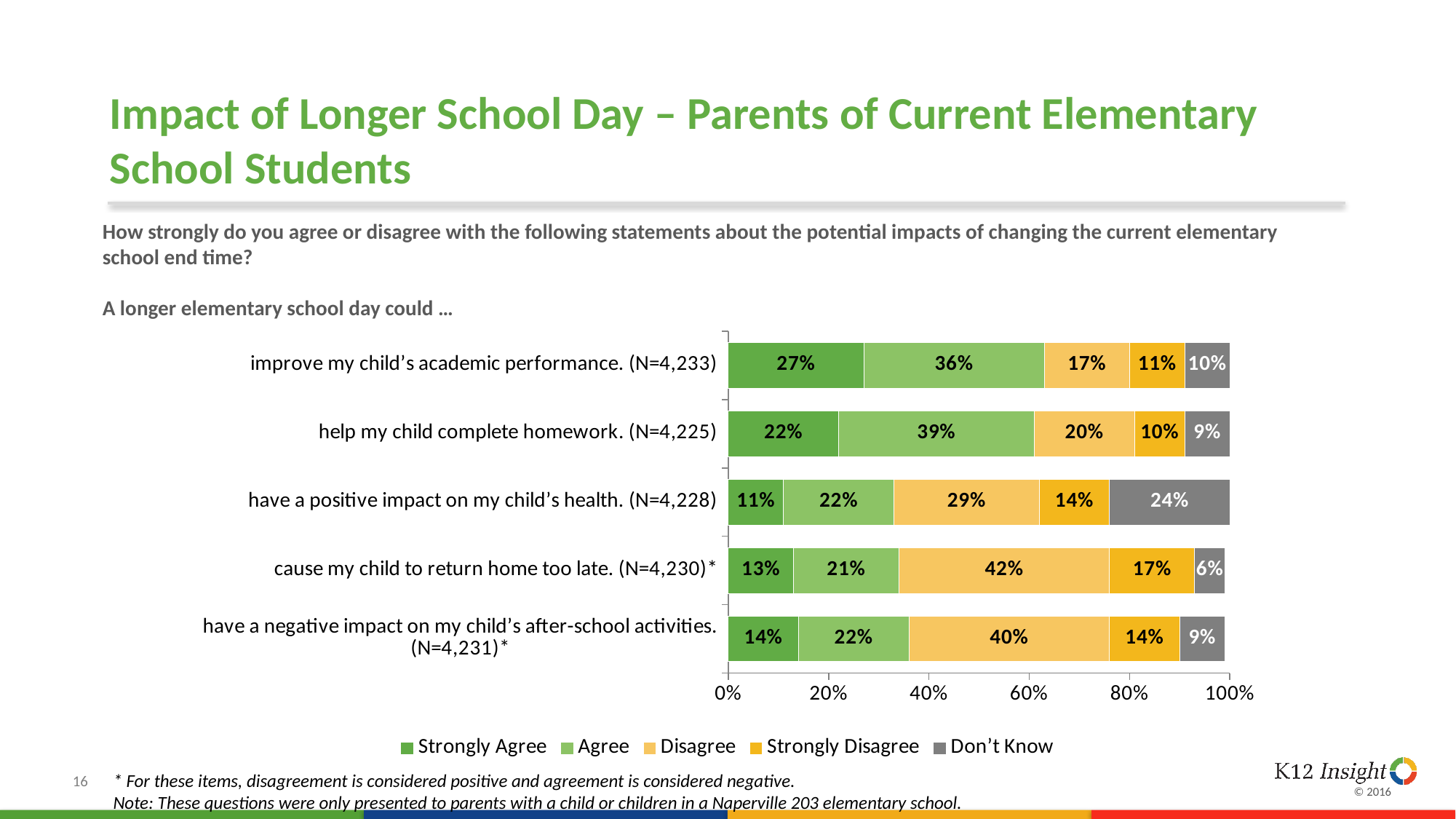
Which statement has the highest 'Strongly Agree' percentage? improve my child's academic performance What percentage of parents strongly agree that a longer elementary school day could improve their child's academic performance? 27% What percentage of parents agree that a longer day could help their child complete homework? 39% What is the difference between the 'Disagree' percentages for 'cause my child to return home too late' and 'have a positive impact on my child's health'? 13% How many statements are shown in the chart? 5 Which is larger: the 'Strongly Disagree' percentage for 'improve my child's academic performance' or for 'cause my child to return home too late'? cause my child to return home too late What is the combined 'Strongly Agree' and 'Agree' percentage for 'help my child complete homework'? 61% What kind of chart is shown on the slide? Stacked bar chart Which statement has the lowest 'Don't Know' percentage? cause my child to return home too late How many response categories does the legend list? 5 What percentage of parents disagree that a longer day could cause their child to return home too late? 42% What percentage of parents answered 'Don't Know' for the statement that a longer day could have a positive impact on their child's health? 24%